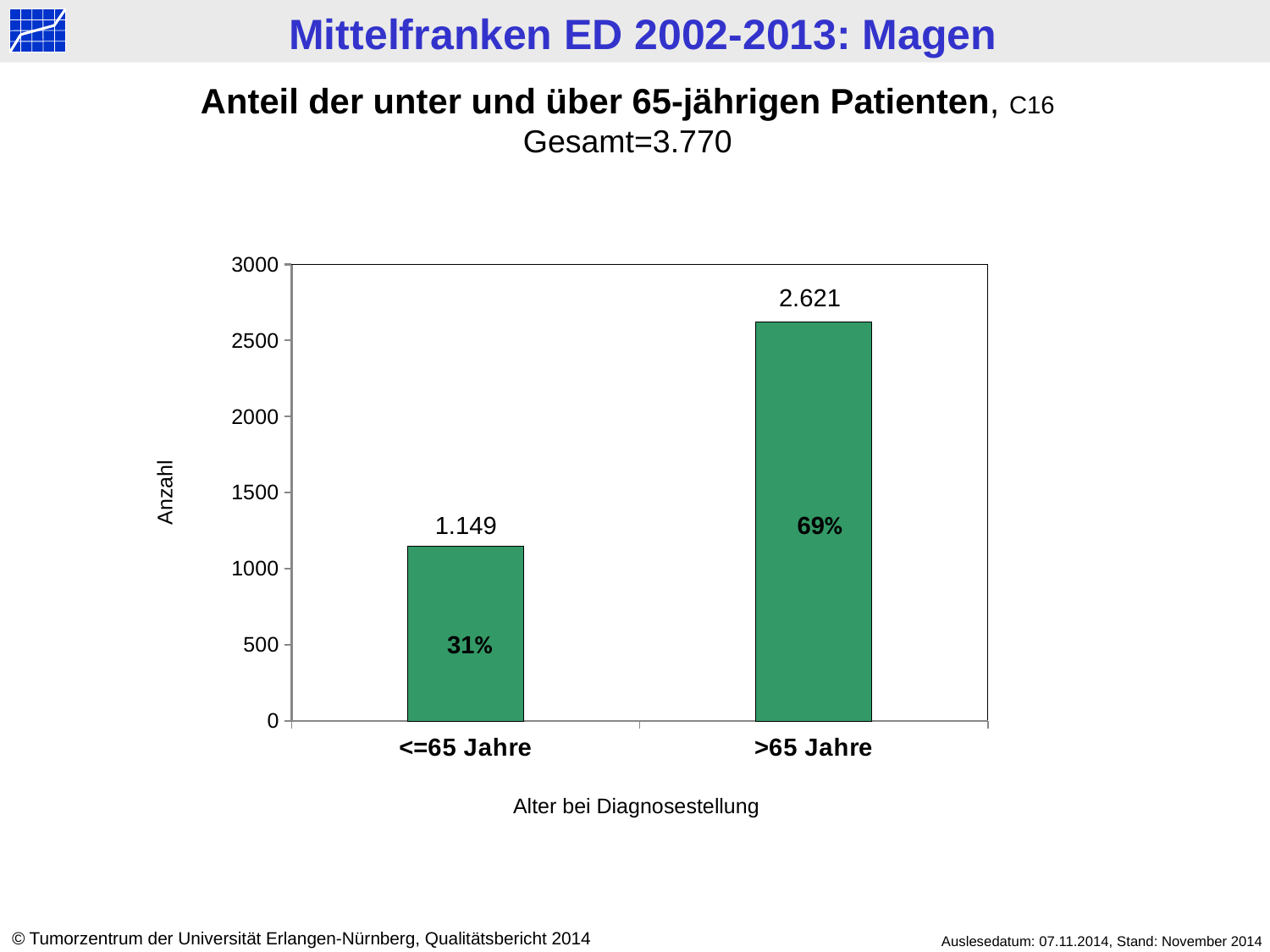
Is the value for ">65 Jahre" greater or less than 2500? greater Which category has the lowest value? <=65 Jahre What is the difference between the values for ">65 Jahre" and "<=65 Jahre"? 1.472 Which is larger, the value for "<=65 Jahre" or for ">65 Jahre"? >65 Jahre What is the value for the ">65 Jahre" category? 2.621 What kind of chart is shown on the slide? bar chart Which category has the highest value? >65 Jahre What is the label of the x axis? Alter bei Diagnosestellung What percentage is shown on the ">65 Jahre" bar? 69% How many categories are shown on the x axis? 2 What percentage is shown on the "<=65 Jahre" bar? 31% What is the value for the "<=65 Jahre" category? 1.149